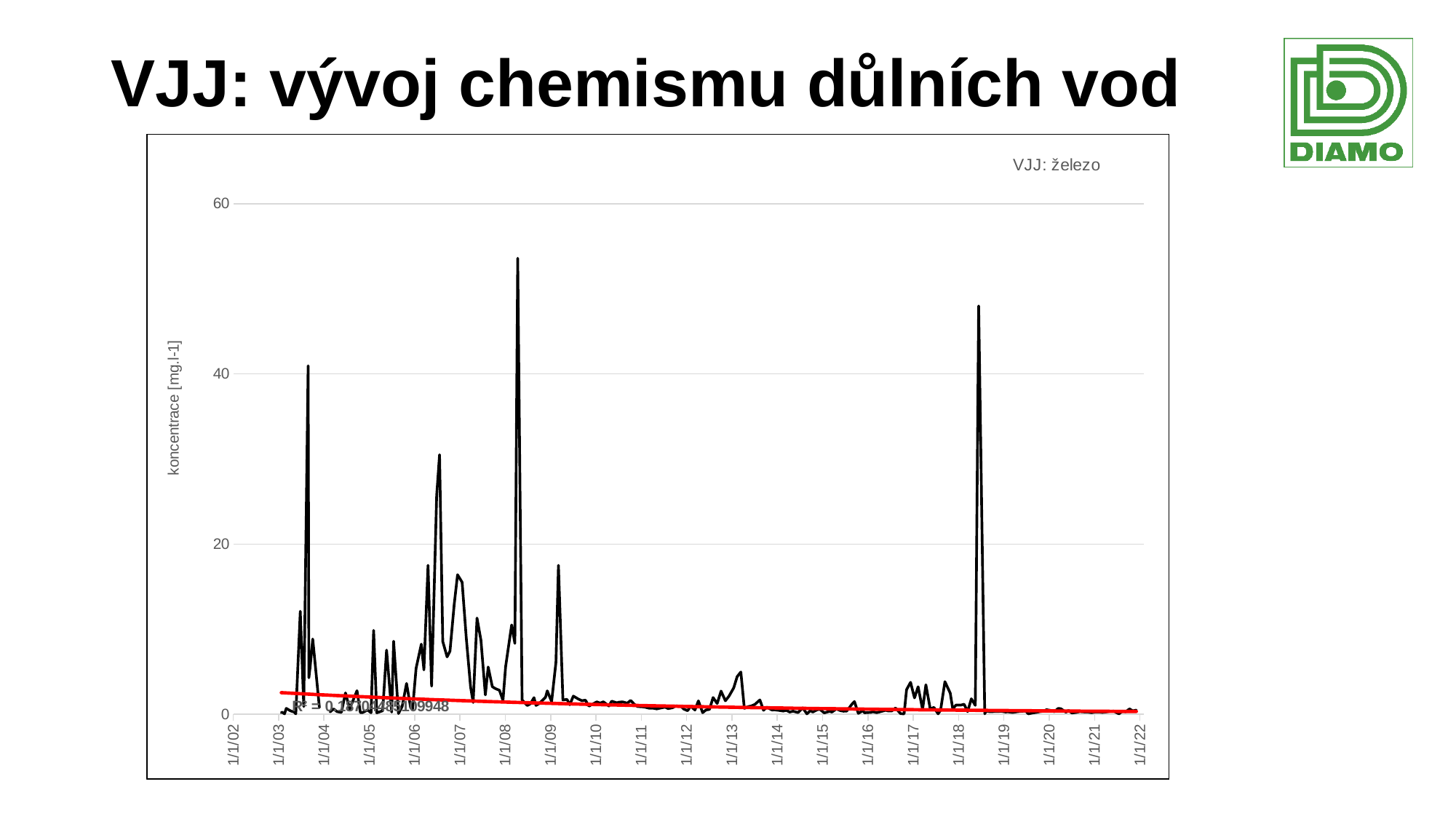
What is the title of the chart? VJJ: železo What kind of chart is shown on the slide? line chart What is the label of the vertical axis? koncentrace [mg.l-1] Is the highest peak of the black line greater or less than 40? greater In which period does the black line reach its highest peak: between 1/1/08 and 1/1/09, or between 1/1/18 and 1/1/19? between 1/1/08 and 1/1/09 Does the red trend line rise or fall from left to right? fall Is the highest peak of the black line greater or less than 60? less Is the peak that occurs between 1/1/18 and 1/1/19 greater or less than 40? greater What is the highest value shown on the vertical axis? 60 How many date labels are shown on the horizontal axis? 21